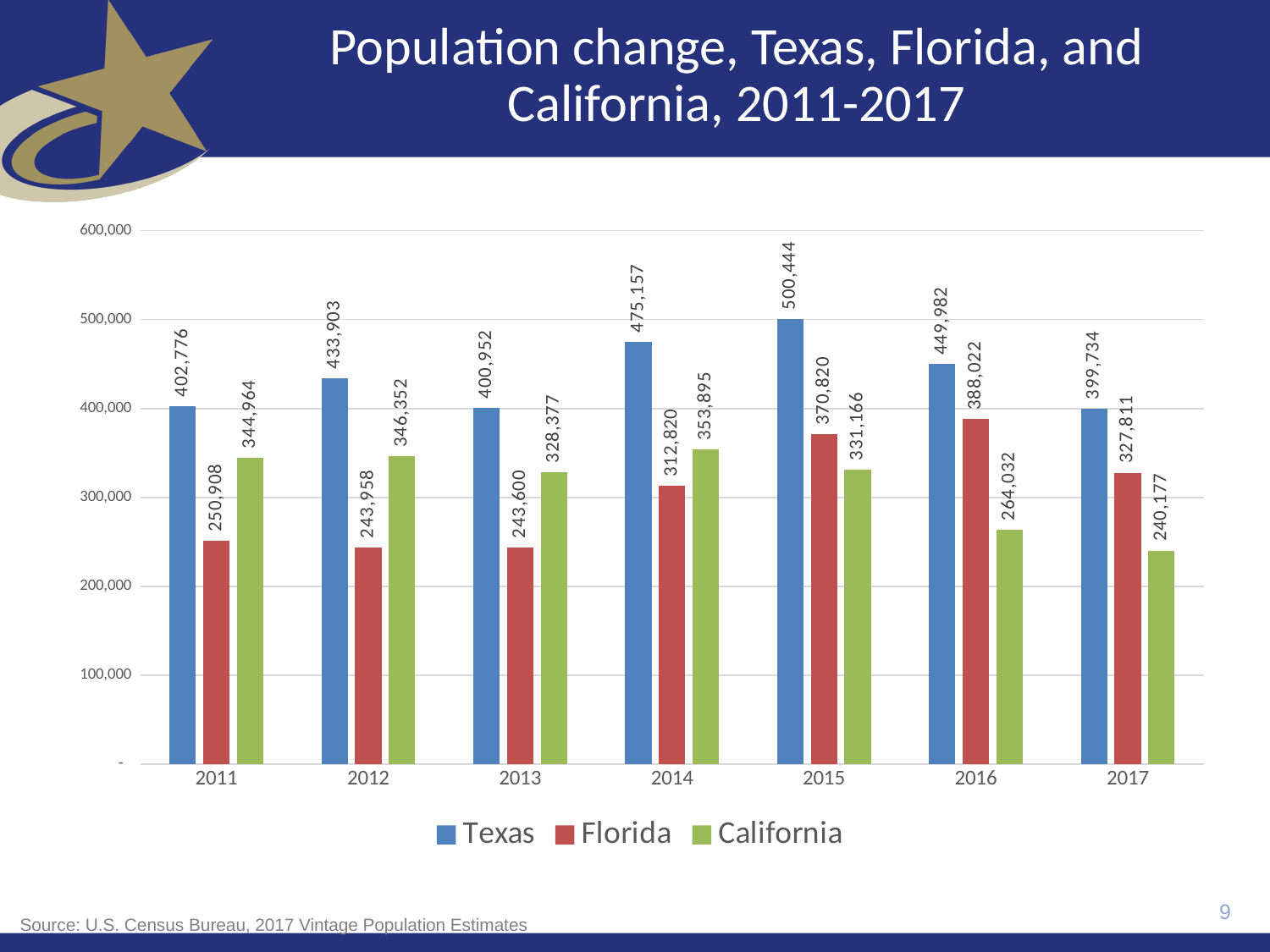
What is the value for Florida in 2013? 243,600 What is the value for California in 2017? 240,177 In which year is the California value lowest? 2017 In 2016, which is larger: the Florida value or the California value? Florida How many years are shown on the x axis? 7 What is the value for Texas in 2015? 500,444 How many series does the legend list? 3 Do the California values rise or fall from 2014 to 2017? fall What is the difference between the Texas and Florida values in 2015? 129,624 What kind of chart is shown on the slide? bar chart In which year is the Texas value highest? 2015 Is the value for Texas in 2014 greater or less than 400,000? greater